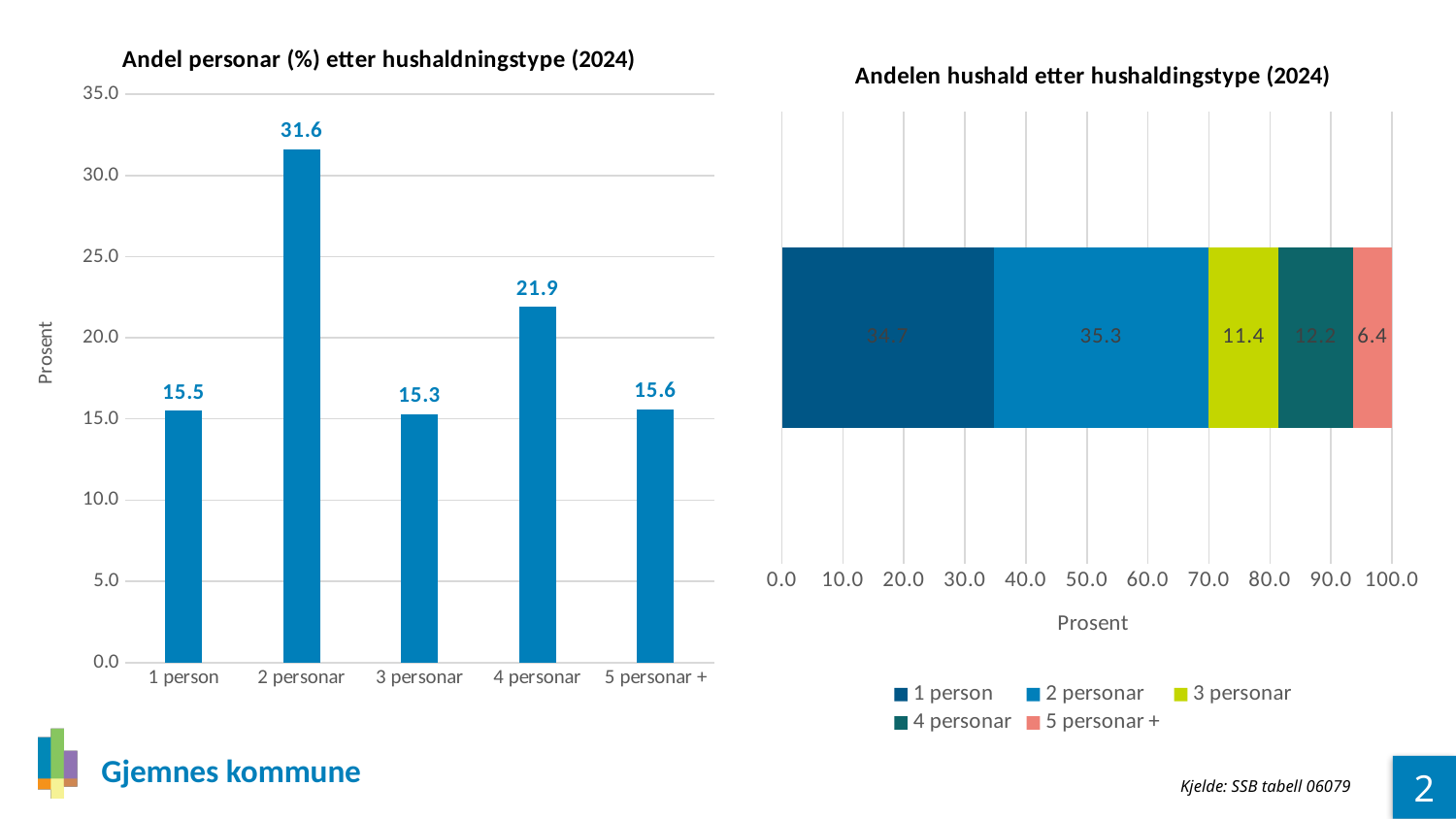
What kind of chart is the left chart? Bar chart In the left chart, what is the value for 2 personar? 31.6 In the left chart, what is the difference between the values for 2 personar and 4 personar? 9.7 How many series does the legend of the right chart list? 5 In the right chart, what is the value for 5 personar +? 6.4 What is the title of the right chart? Andelen hushald etter hushaldingstype (2024) In the left chart, how many household categories are shown on the x axis? 5 In the left chart, what is the value for 4 personar? 21.9 In the right chart, which household type has the smallest share? 5 personar + In the left chart, which household type has the highest share? 2 personar In the left chart, is the value for 1 person greater or less than 20.0? less In the right chart, what is the value for 3 personar? 11.4